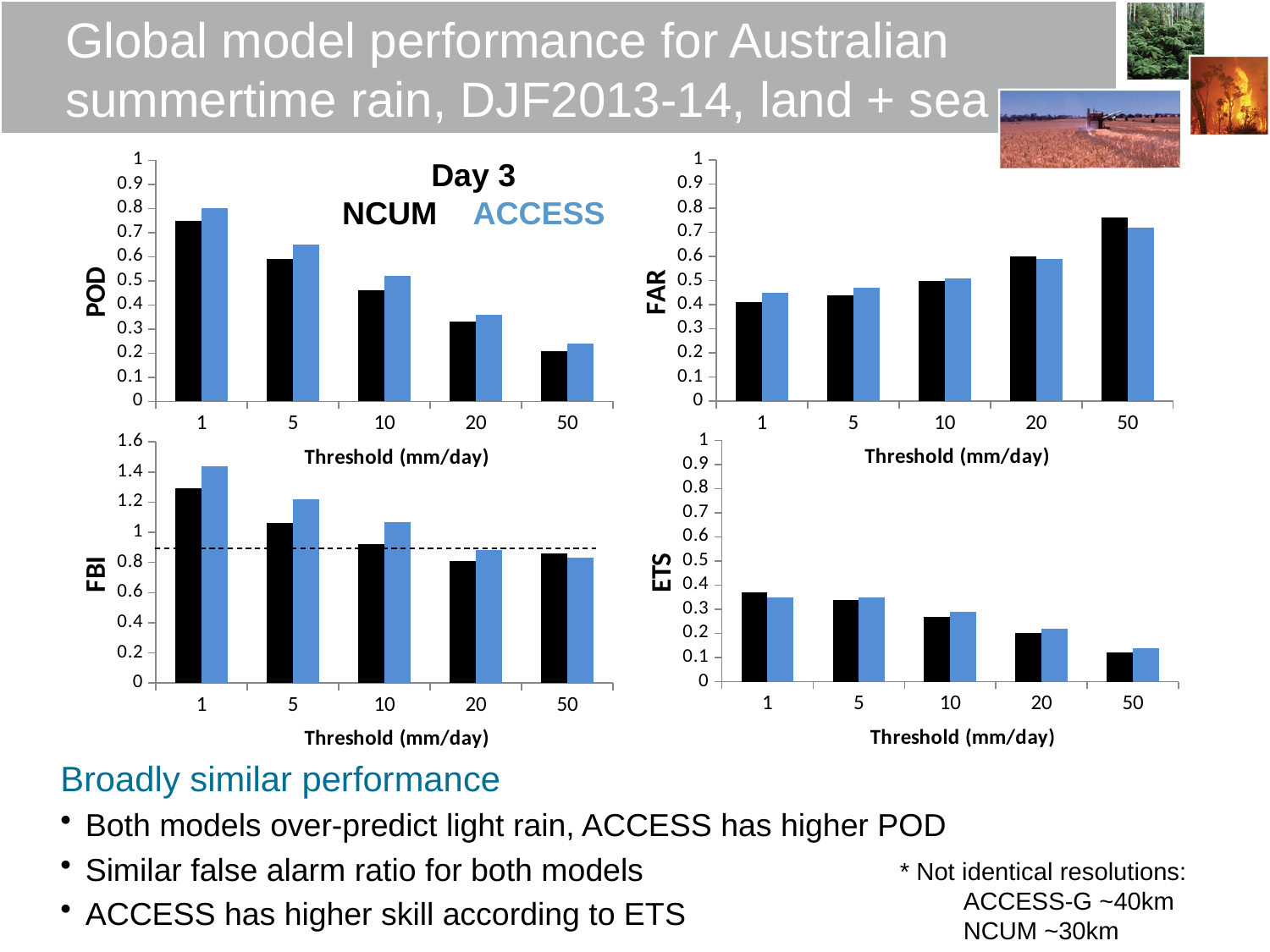
In the POD chart, how many threshold categories are shown on the x axis? 5 In the FAR chart, at which threshold is the NCUM value highest? 50 In the FBI chart, is the NCUM value at the 1 mm/day threshold greater or less than 1.2? greater How many series does the legend list for the charts? 2 In the ETS chart, at which threshold is the ACCESS value lowest? 50 What is the x-axis title shared by the four charts? Threshold (mm/day) In the POD chart, do the values rise or fall as the threshold increases from 1 to 50 mm/day? fall In the FAR chart, do the values rise or fall as the threshold increases from 1 to 50 mm/day? rise In the POD chart, is the ACCESS value at the 50 mm/day threshold greater or less than 0.3? less What kind of chart is the POD chart? bar chart In the FBI chart, is the NCUM value at the 20 mm/day threshold greater or less than 1? less In the POD chart, which model has the higher value at the 1 mm/day threshold? ACCESS